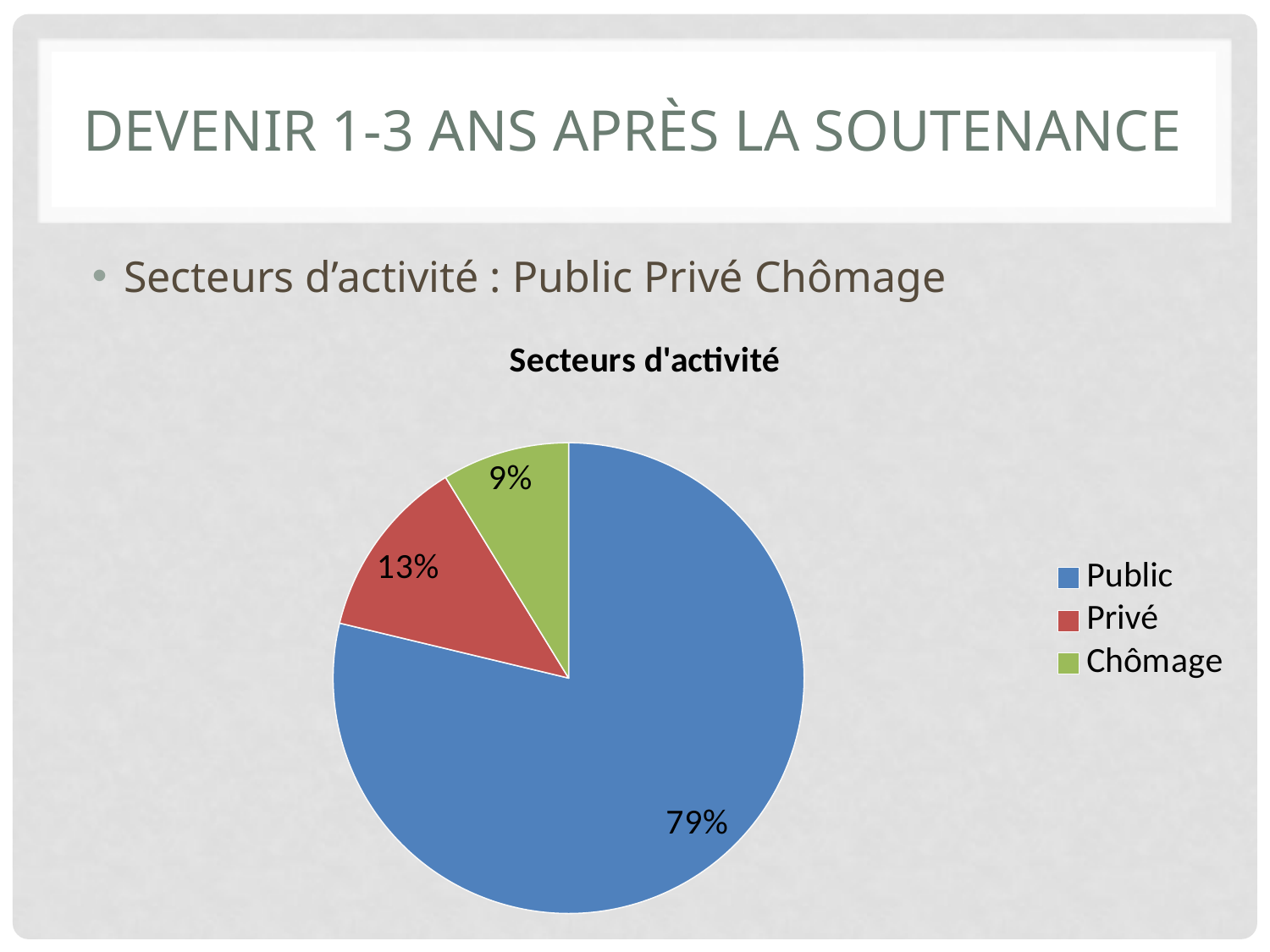
What share of the pie does Chômage represent? 9% How many categories does the pie chart show? 3 What is the difference in percentage points between Privé and Chômage? 4 What is the difference in percentage points between Public and Privé? 66 Which is larger, the share for Privé or the share for Chômage? Privé Which colour represents Chômage in the legend? green What is the title of the chart? Secteurs d'activité What share of the pie does Privé represent? 13% What type of chart is shown on the slide? pie chart Which category has the largest slice of the pie? Public Which category has the smallest slice of the pie? Chômage What share of the pie does Public represent? 79%